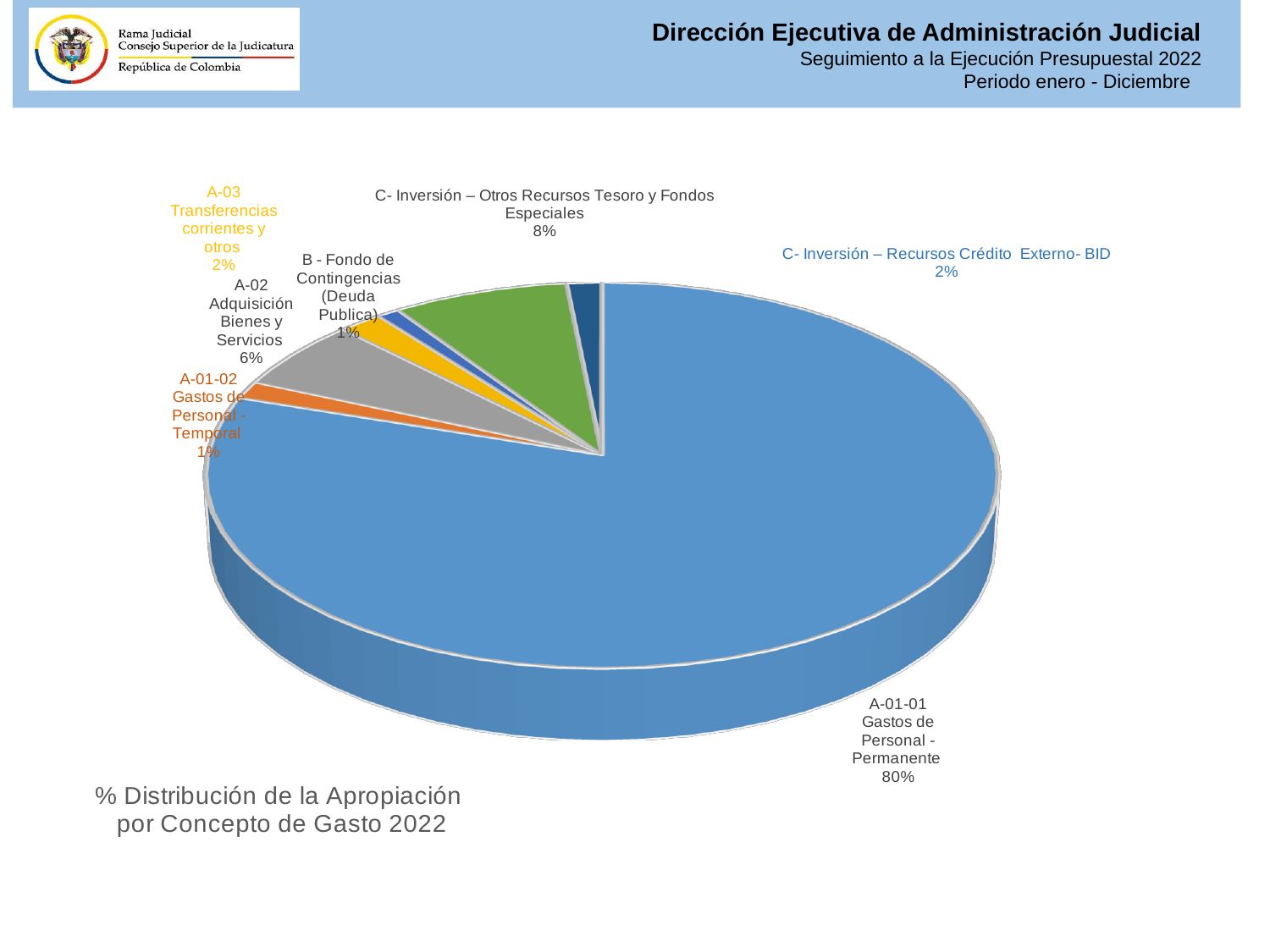
What percentage is shown for B - Fondo de Contingencias (Deuda Publica)? 1% What percentage is shown for A-03 Transferencias corrientes y otros? 2% What is the title of the chart? % Distribución de la Apropiación por Concepto de Gasto 2022 What share of the pie does A-01-01 Gastos de Personal - Permanente represent? 80% What is the difference in percentage points between A-01-01 Gastos de Personal - Permanente and C- Inversión – Otros Recursos Tesoro y Fondos Especiales? 72 percentage points Which category has the largest share of the pie? A-01-01 Gastos de Personal - Permanente What percentage is shown for C- Inversión – Recursos Crédito Externo- BID? 2% What percentage is shown for C- Inversión – Otros Recursos Tesoro y Fondos Especiales? 8% How many slices does the pie chart have? 7 Which is larger, the share for A-02 Adquisición Bienes y Servicios or the share for C- Inversión – Otros Recursos Tesoro y Fondos Especiales? C- Inversión – Otros Recursos Tesoro y Fondos Especiales What type of chart is shown on the slide? Pie chart What percentage is shown for A-02 Adquisición Bienes y Servicios? 6%